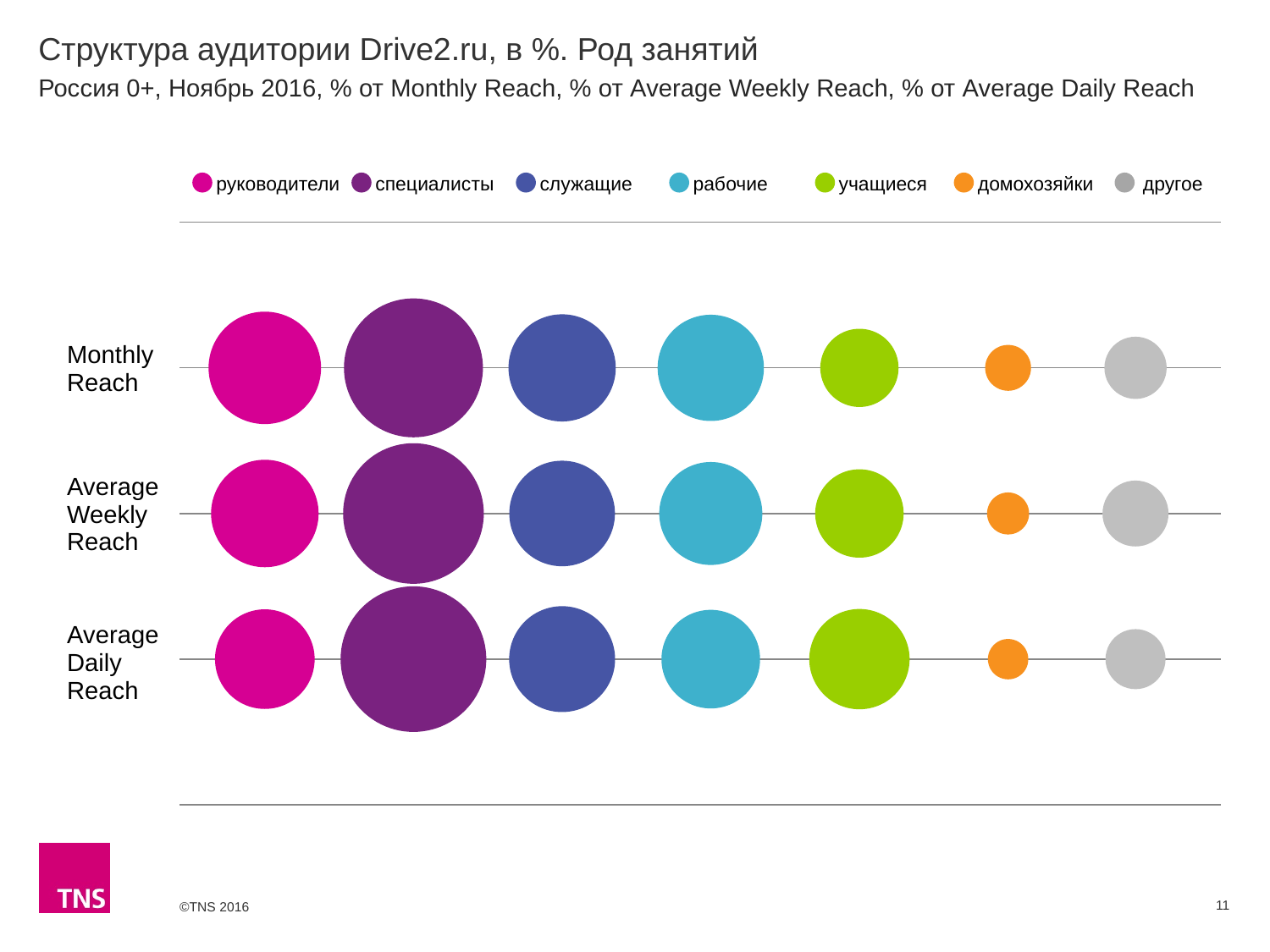
What kind of chart is shown on the slide? bubble chart In the Average Daily Reach row, which bubble is larger: специалисты or другое? специалисты How many reach rows (Monthly, Weekly, Daily) are plotted on the chart? 3 How many categories does the legend list? 7 In the Average Weekly Reach row, which bubble is larger: руководители or домохозяйки? руководители In the Monthly Reach row, which bubble is larger: учащиеся or домохозяйки? учащиеся What is the title of the chart on the slide? Структура аудитории Drive2.ru, в %. Род занятий What colour represents the category рабочие in the legend? light blue Which occupation group has the smallest bubble in the Average Weekly Reach row? домохозяйки Which occupation group has the largest bubble in the Monthly Reach row? специалисты Which occupation group has the largest bubble in the Average Daily Reach row? специалисты Which occupation group has the smallest bubble in the Monthly Reach row? домохозяйки